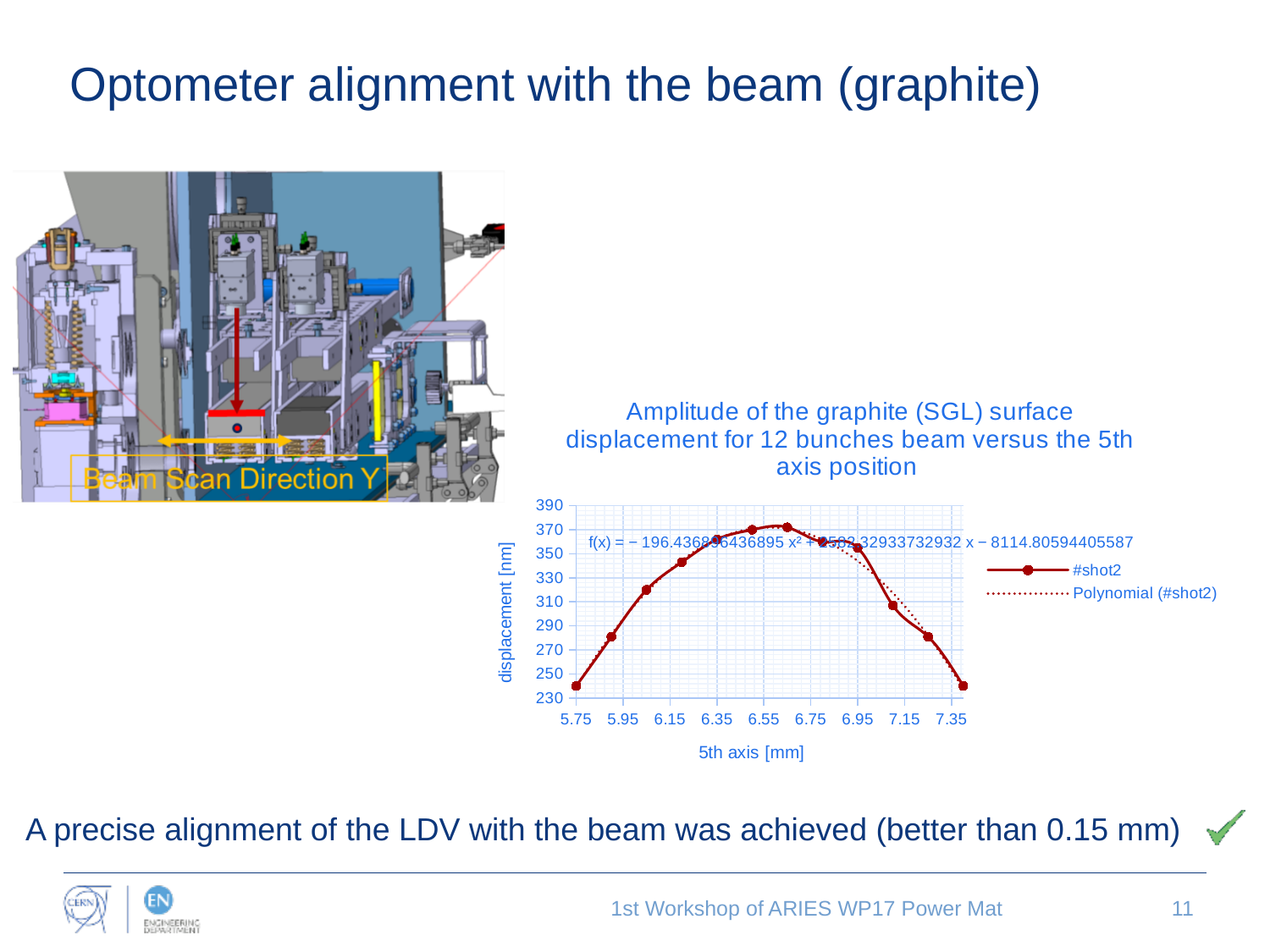
What is the lowest value shown on the chart's y axis? 230 What are the two entries in the chart legend? #shot2 and Polynomial (#shot2) What is the label of the chart's x axis? 5th axis [mm] What kind of chart is shown on the slide? line chart How many series does the chart legend list? 2 How does the #shot2 displacement change as the 5th axis position increases from 5.75 mm to 7.35 mm? rises to a peak then falls Is the #shot2 displacement at 5.75 mm greater or less than 250 nm? less How many data points are plotted for the #shot2 series? 12 Is the highest #shot2 displacement value greater or less than 350 nm? greater Is the #shot2 displacement at 5.75 mm greater or less than the peak displacement near 6.55 mm? less